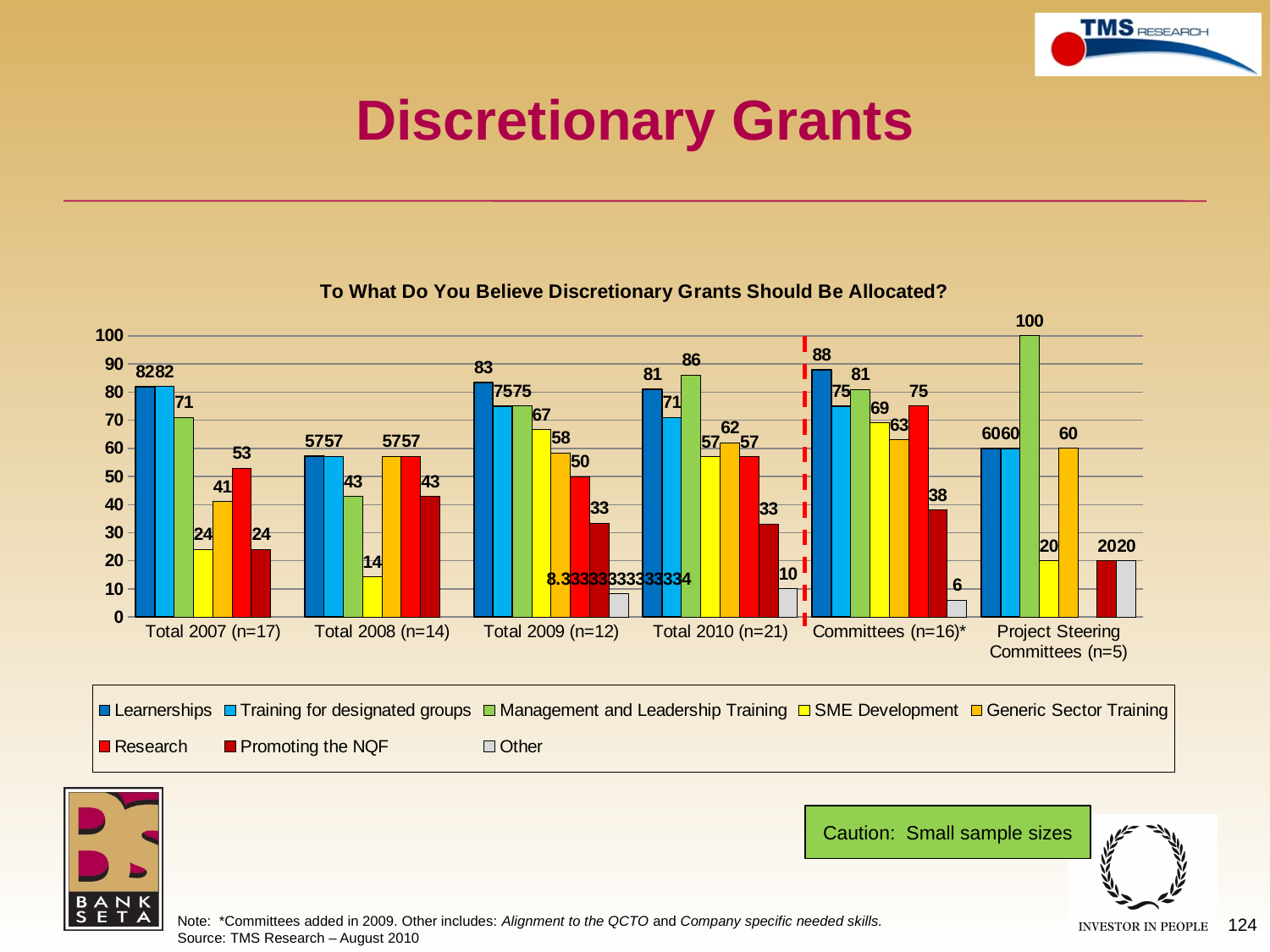
What is the value for Research in the Total 2007 (n=17) group? 53 Which series has the lowest value in the Committees (n=16)* group? Other In the Total 2010 (n=21) group, which is larger: Learnerships or Management and Leadership Training? Management and Leadership Training What kind of chart is shown on the slide? bar chart What is the value for Management and Leadership Training in the Project Steering Committees (n=5) group? 100 Which category has the highest value for Management and Leadership Training? Project Steering Committees (n=5) What is the value for Learnerships in the Committees (n=16)* group? 88 What is the difference between the Learnerships values for Total 2009 (n=12) and Total 2008 (n=14)? 26 What is the title of the chart? To What Do You Believe Discretionary Grants Should Be Allocated? How many series does the legend list? 8 How many categories are shown along the x axis? 6 What is the value for SME Development in the Total 2008 (n=14) group? 14